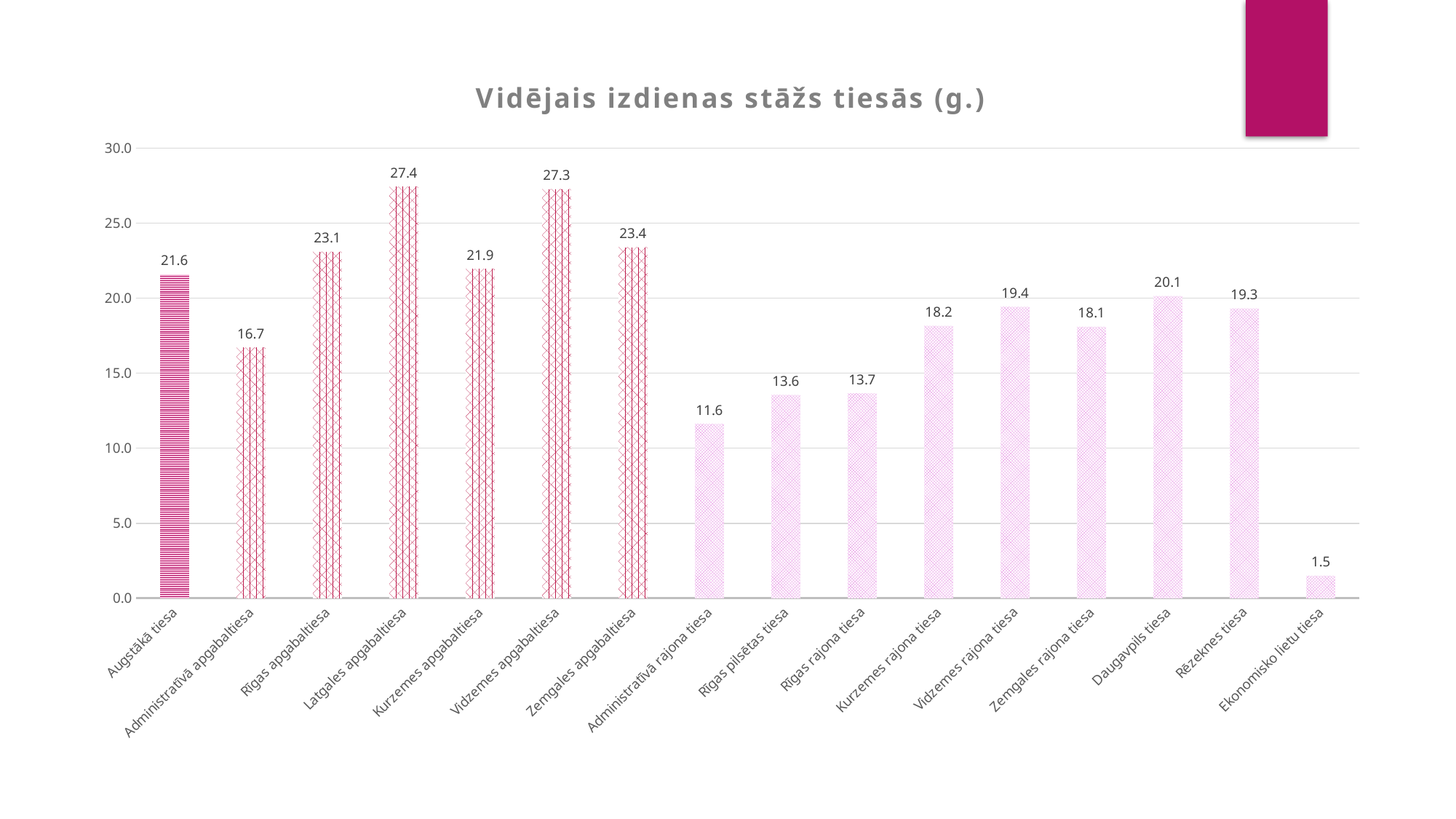
Which category has the lowest value? Ekonomisko lietu tiesa What is the value for Administratīvā rajona tiesa? 11.6 Is the value for Rēzeknes tiesa greater or less than 20.0? less What kind of chart is shown on the slide? bar chart What is the difference between the values for Zemgales apgabaltiesa and Administratīvā apgabaltiesa? 6.7 Which is larger, the value for Rīgas apgabaltiesa or the value for Kurzemes apgabaltiesa? Rīgas apgabaltiesa Which category has the highest value? Latgales apgabaltiesa What is the title of the chart? Vidējais izdienas stāžs tiesās (g.) What is the value for Augstākā tiesa? 21.6 How many categories are shown on the x axis? 16 What is the value for Daugavpils tiesa? 20.1 What is the value for Latgales apgabaltiesa? 27.4